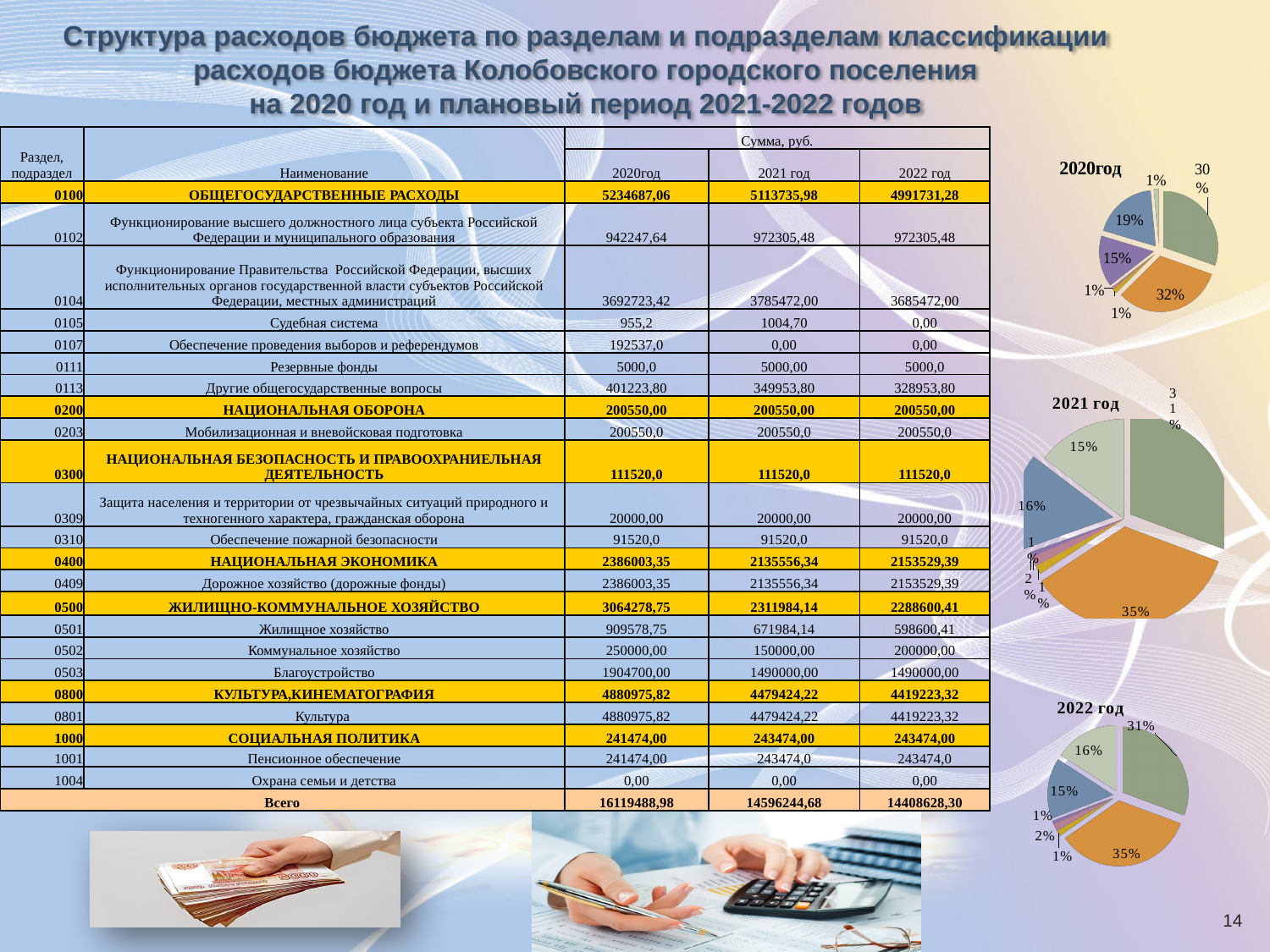
In the "2020год" pie chart, what is the difference in percentage points between the two largest slices (32% and 30%)? 2 What are the titles of the three pie charts on the slide? 2020год, 2021 год, 2022 год Which pie chart has the larger biggest slice, "2020год" or "2021 год"? 2021 год In the "2021 год" pie chart, what is the percentage of the largest slice? 35% What kind of chart is the chart titled "2020год"? pie chart In the "2022 год" pie chart, what percentage is shown for the second-largest slice? 31% How many slices does the "2022 год" pie chart have? 7 In the "2021 год" pie chart, what is the difference in percentage points between the two largest slices (35% and 31%)? 4 In the "2022 год" pie chart, what is the percentage of the largest slice? 35% In the "2020год" pie chart, what is the percentage of the largest slice? 32% In the "2020год" pie chart, what is the percentage of the smallest labelled slice? 1% How many pie charts are shown on the slide? 3